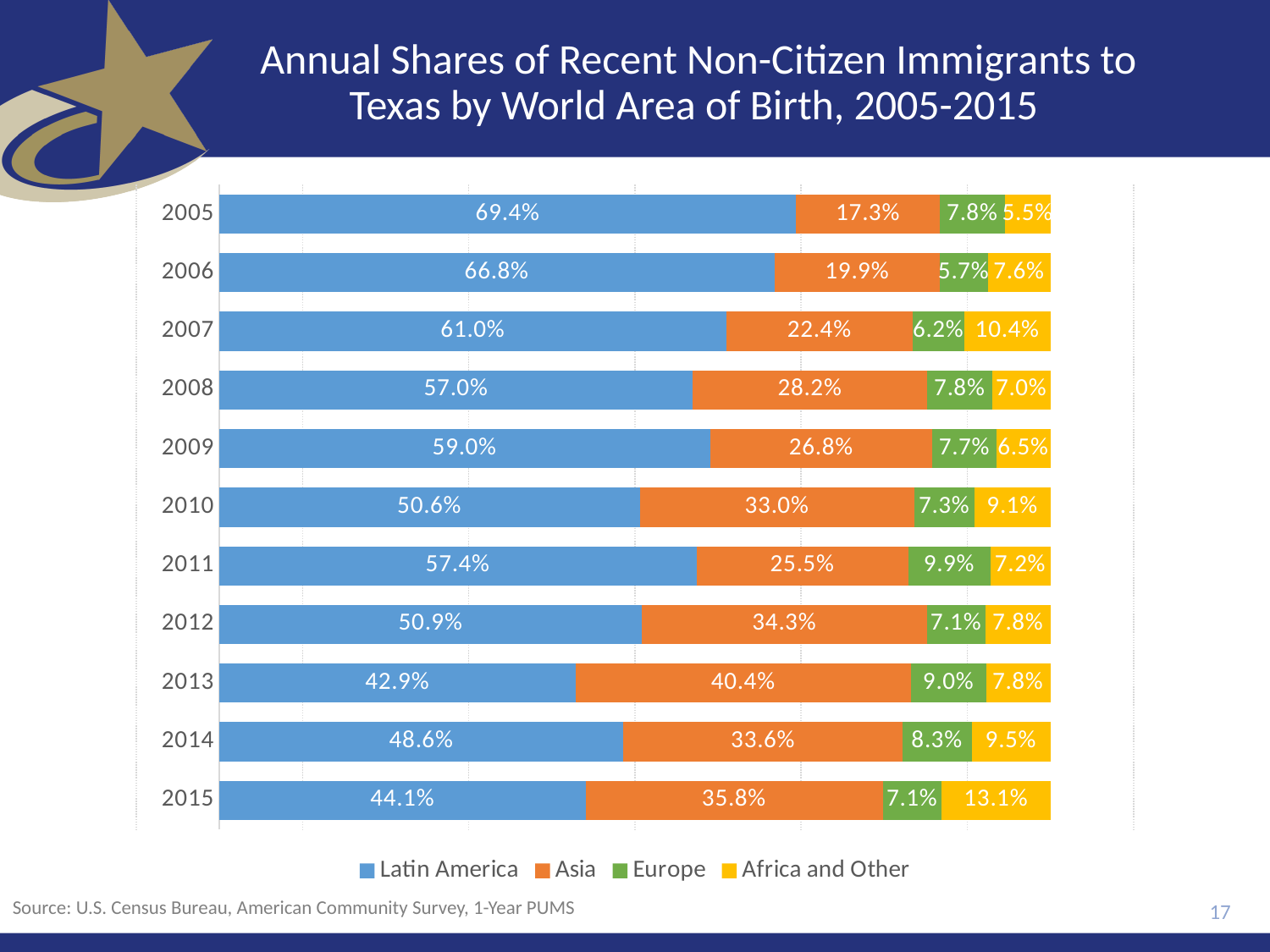
What share of recent non-citizen immigrants to Texas in 2005 were born in Latin America? 69.4% What was the Europe share in 2011? 9.9% In which year was the Asia share the highest? 2013 What was the Africa and Other share in 2015? 13.1% What kind of chart is shown on the slide? Stacked bar chart What was the Asia share in 2013? 40.4% In 2011, which was larger: the Europe share or the Africa and Other share? Europe In which year was the Latin America share the highest? 2005 How many years are shown on the chart? 11 In which year was the Latin America share the lowest? 2013 How many series does the legend list? 4 By how many percentage points did the Latin America share fall from 2005 to 2015? 25.3 percentage points